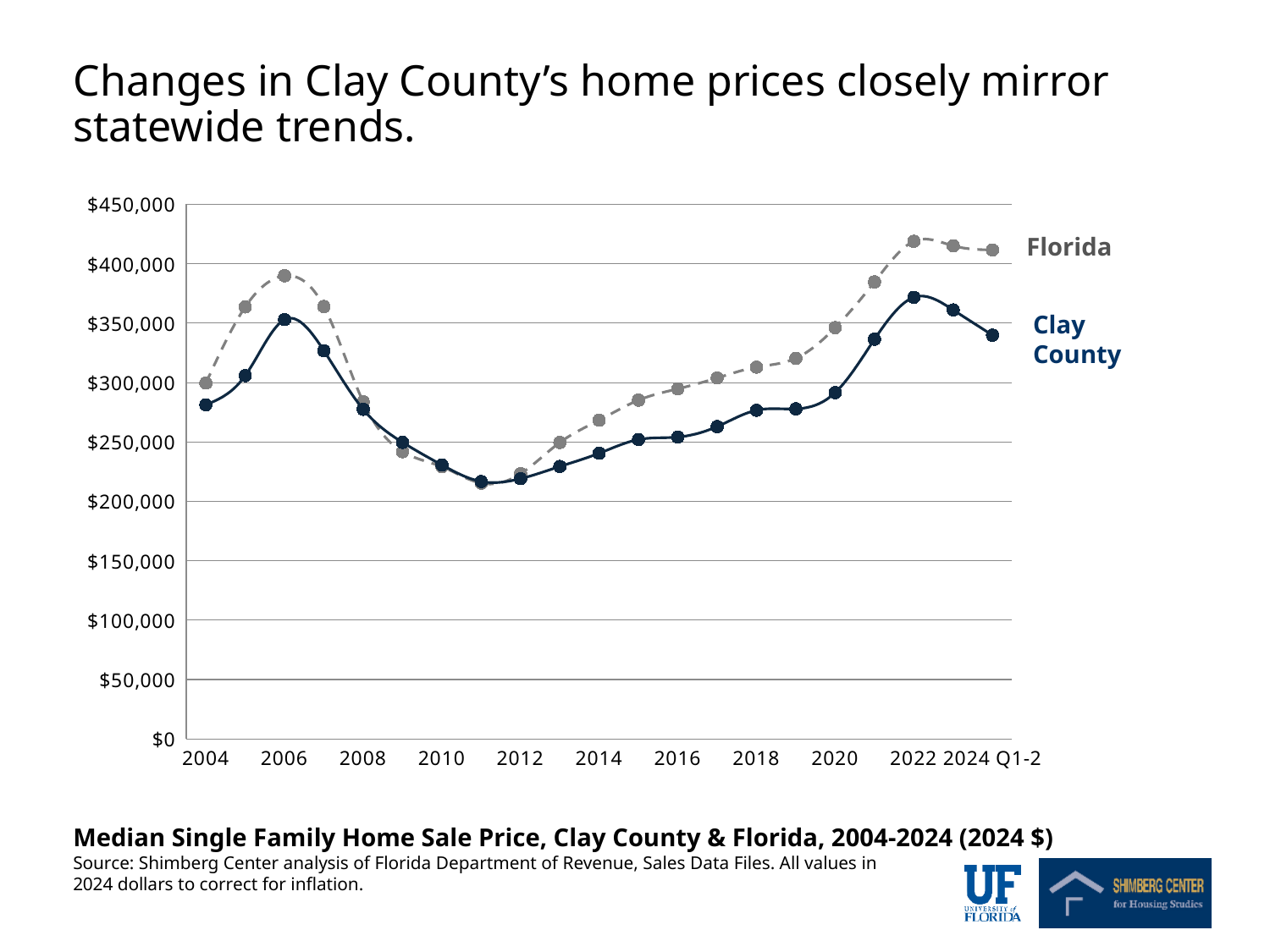
In which year does the Clay County series reach its highest value? 2022 What kind of chart is shown on the slide? Line chart How many series are plotted on the chart? 2 Is the Clay County value for 2022 greater or less than $400,000? less In which year does the Florida series reach its highest value? 2022 Which series is drawn as a gray dashed line? Florida Is the Clay County value for 2011 greater or less than $250,000? less In 2022, which series has the higher value, Florida or Clay County? Florida Does the Clay County series rise or fall between 2011 and 2022? Rise Is the Florida value for 2022 greater or less than $400,000? greater What is the title of the chart? Median Single Family Home Sale Price, Clay County & Florida, 2004-2024 (2024 $)